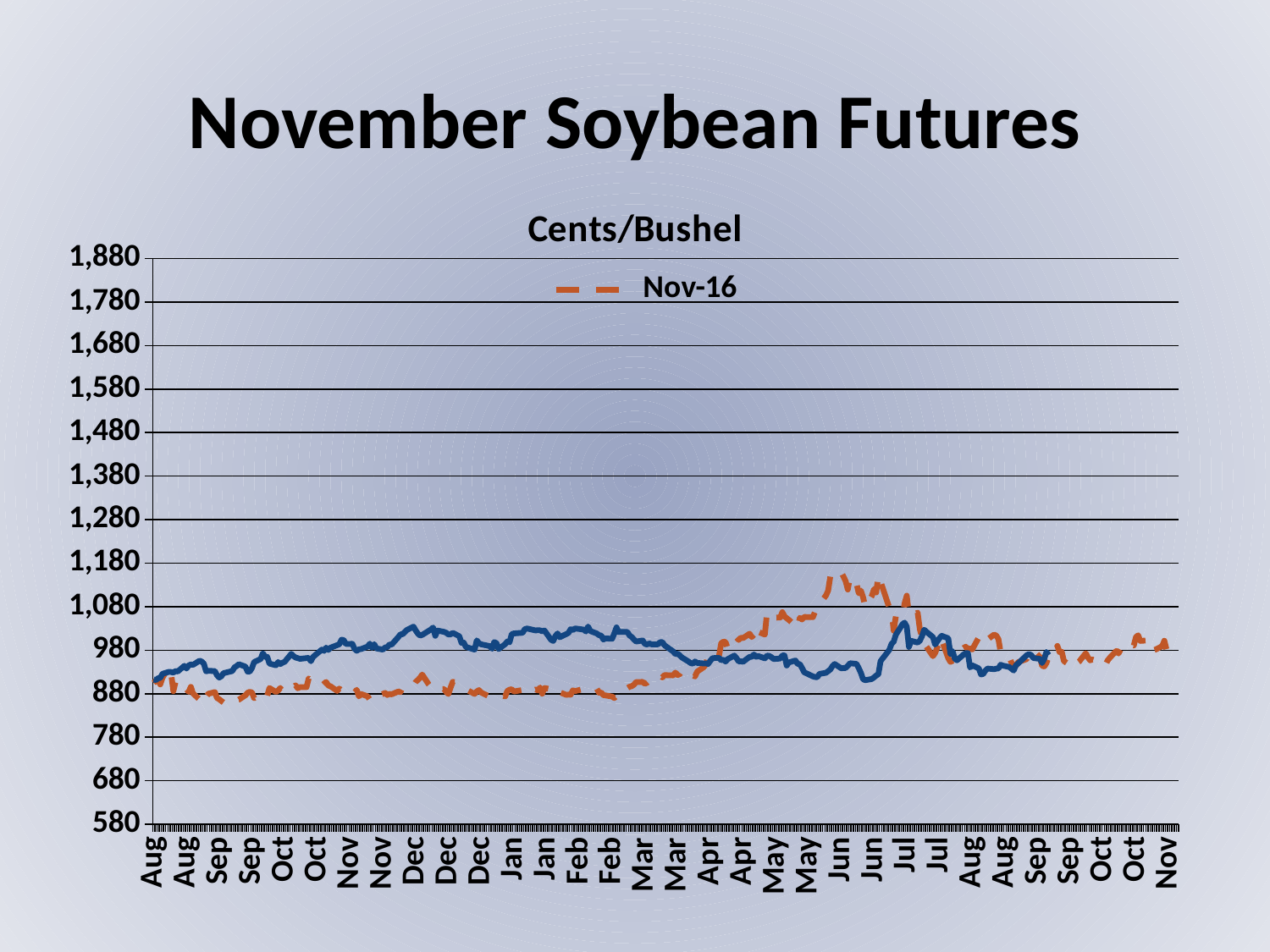
What kind of chart is shown on the slide? line chart What is the lowest value shown on the y axis? 580 In which month does the Nov-16 series reach its highest point? Jun Is the peak value of the Nov-16 series in June greater or less than 1,080? greater How many series does the legend list? 1 Is the value of the Nov-16 series in February greater or less than 980? less Does the Nov-16 series rise or fall between early June and August? fall What is the highest value shown on the y axis? 1,880 What is the title of the chart? Cents/Bushel Does the Nov-16 series rise or fall between April and early June? rise Is the value of the Nov-16 series in early November greater or less than 1,080? less What series name appears in the legend? Nov-16